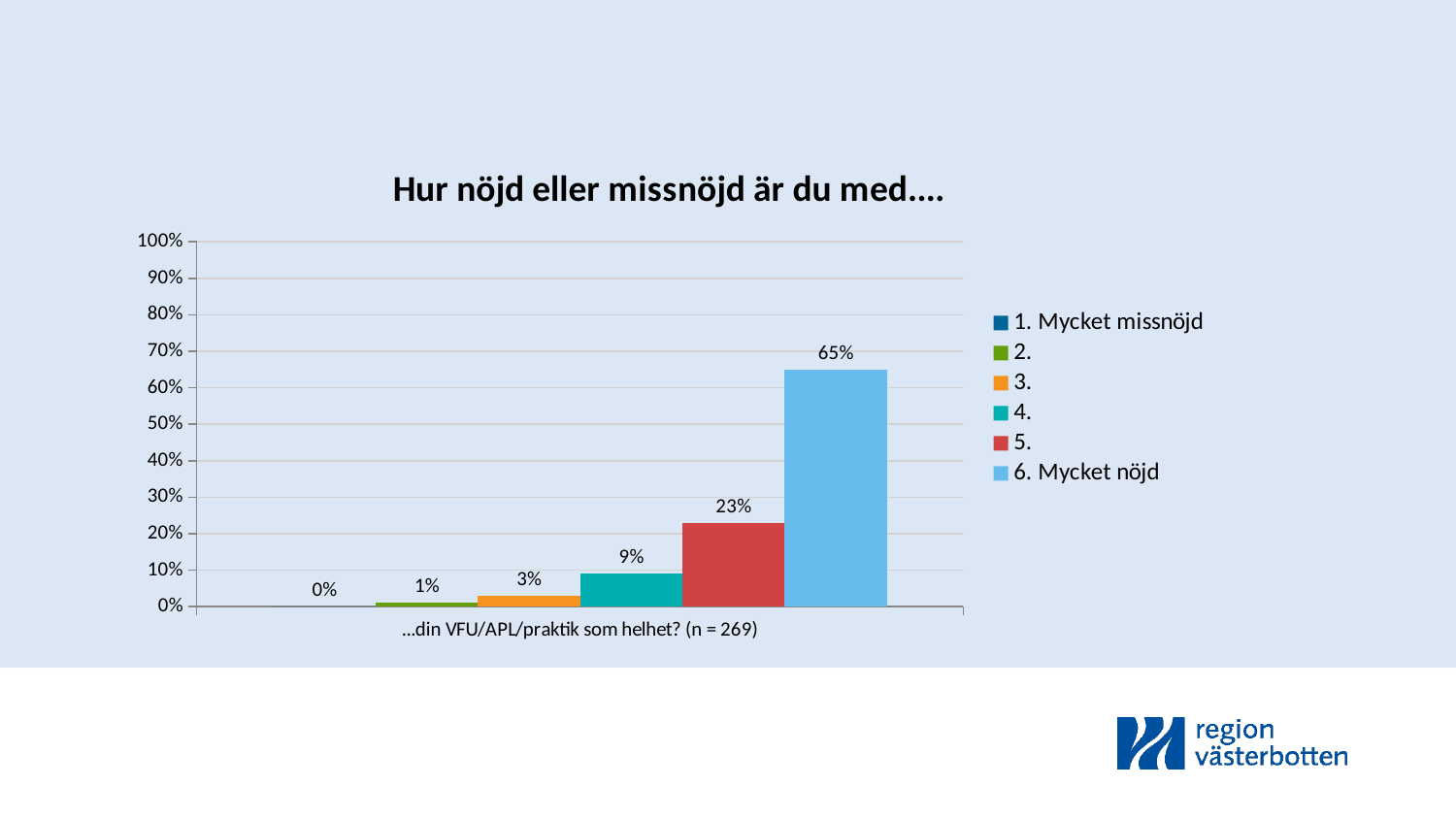
What kind of chart is shown on the slide? Bar chart What is the difference between the values for "6. Mycket nöjd" and "5."? 42% Is the value for "6. Mycket nöjd" greater or less than 60%? greater What is the value for "6. Mycket nöjd"? 65% Which series has the highest value? 6. Mycket nöjd Which is larger, the value for "3." or the value for "4."? 4. What is the value for "4."? 9% What is the value for "1. Mycket missnöjd"? 0% How many series does the legend list? 6 Which series has the lowest value? 1. Mycket missnöjd What is the value for "5."? 23% What is the title of the chart? Hur nöjd eller missnöjd är du med....